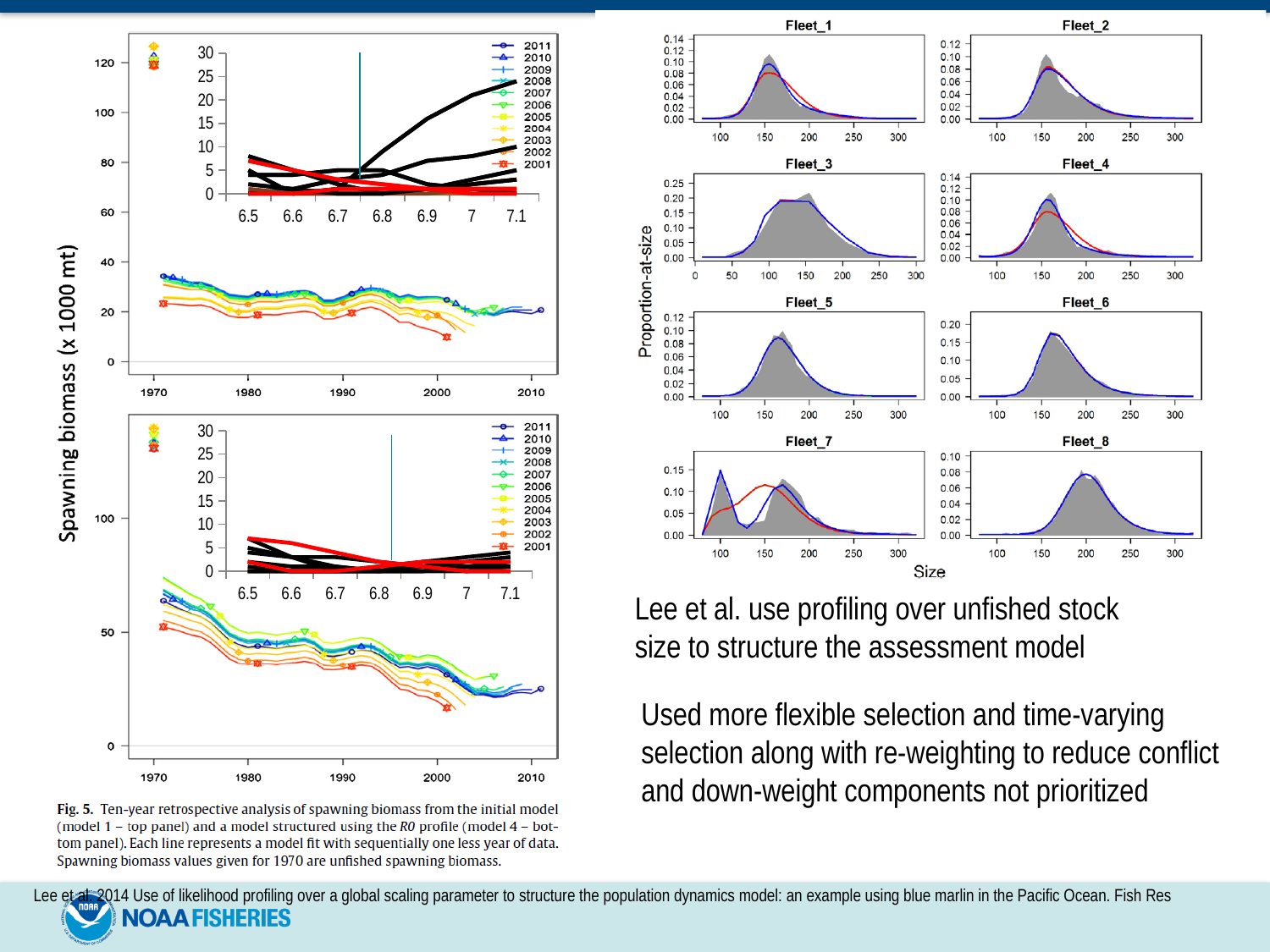
In the top spawning biomass panel, are the 1970 unfished spawning biomass points greater or less than 100? greater In the bottom spawning biomass panel, are the 1970 unfished spawning biomass points greater or less than 100? greater In the bottom spawning biomass panel, is the 2011 line's value at 2010 greater or less than 50? less What is the y-axis label of the left-hand spawning biomass charts? Spawning biomass (x 1000 mt) How many fleet panels (Fleet_1 through Fleet_8) are shown in the proportion-at-size charts on the right side of the slide? 8 In the top spawning biomass panel, how many years does the legend list? 11 What is the highest y-axis tick shown on the Fleet_3 panel? 0.25 Which fleet panel has its peak proportion-at-size at a larger size, Fleet_8 or Fleet_1? Fleet_8 In the bottom spawning biomass panel, do the lines generally rise or fall from 1970 to 2010? Fall Which fleet panel's x-axis starts at 0 rather than 100? Fleet_3 What kind of chart is the top spawning biomass panel on the left? Line chart